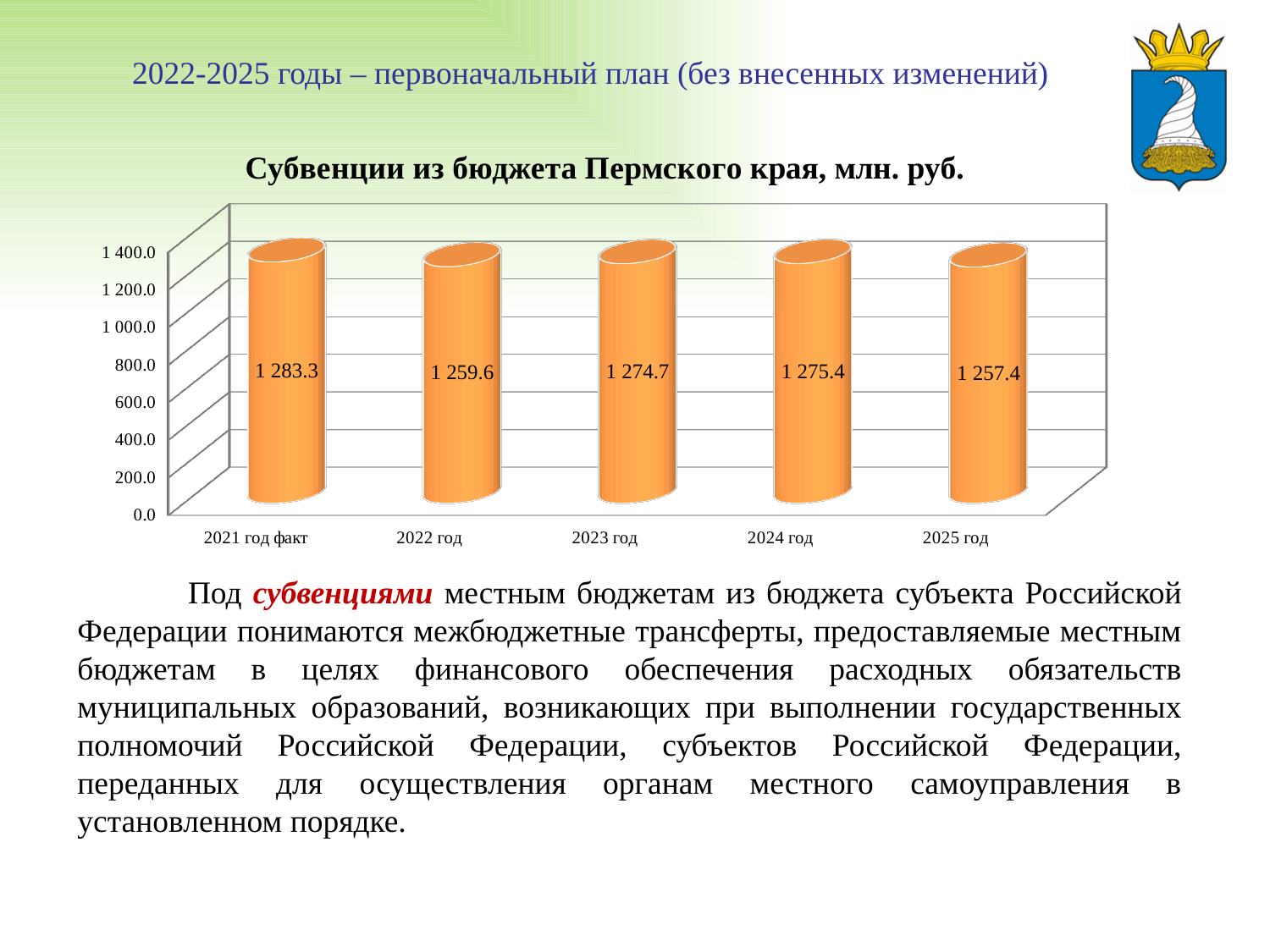
Which category has the lowest value? 2025 год Which category has the highest value? 2021 год факт What is the difference between the values for 2023 год and 2025 год? 17.3 What is the difference between the values for 2021 год факт and 2022 год? 23.7 How many categories are shown on the x axis? 5 Which is larger, the value for 2024 год or the value for 2025 год? 2024 год What is the value for 2022 год? 1 259.6 What is the value for 2025 год? 1 257.4 What is the value for 2023 год? 1 274.7 What is the value for 2021 год факт in the chart «Субвенции из бюджета Пермского края, млн. руб.»? 1 283.3 What kind of chart is shown on the slide? bar chart Is the value for 2022 год greater or less than 1 200.0? greater